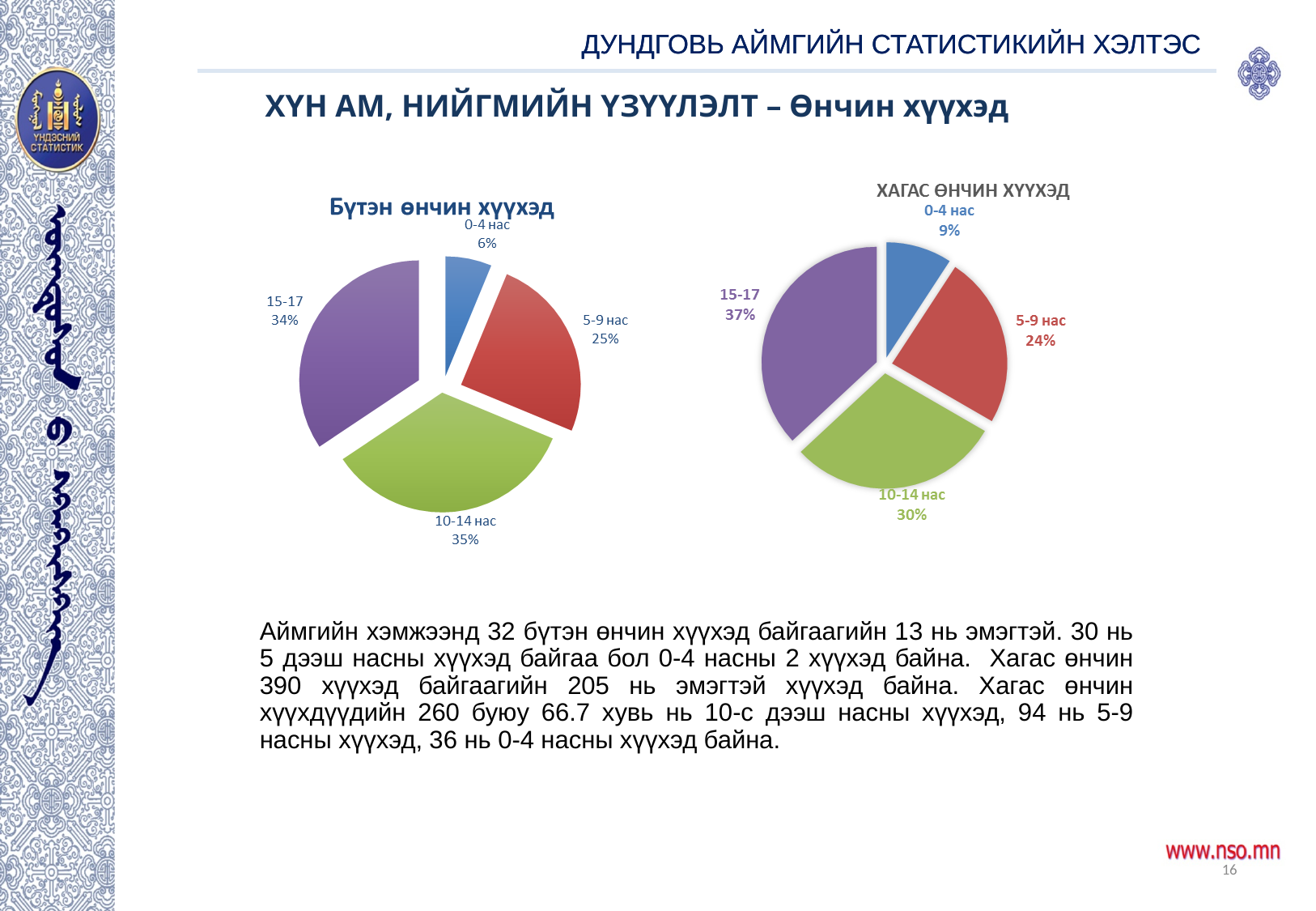
In the "ХАГАС ӨНЧИН ХҮҮХЭД" chart, which age group has the largest slice? 15-17 In the "ХАГАС ӨНЧИН ХҮҮХЭД" chart, what share does the 15-17 slice have? 37% In the "ХАГАС ӨНЧИН ХҮҮХЭД" chart, what is the difference in percentage points between the 10-14 нас and 5-9 нас slices? 6 In the "Бүтэн өнчин хүүхэд" chart, what share does the 10-14 нас slice have? 35% In the "ХАГАС ӨНЧИН ХҮҮХЭД" chart, what share does the 0-4 нас slice have? 9% What type of chart is used for "Бүтэн өнчин хүүхэд"? pie chart In the "Бүтэн өнчин хүүхэд" chart, what is the difference in percentage points between the 15-17 and 0-4 нас slices? 28 Which chart has a larger share for 0-4 нас, "Бүтэн өнчин хүүхэд" or "ХАГАС ӨНЧИН ХҮҮХЭД"? ХАГАС ӨНЧИН ХҮҮХЭД What is the title of the pie chart on the right side of the slide? ХАГАС ӨНЧИН ХҮҮХЭД How many slices does the "Бүтэн өнчин хүүхэд" pie chart have? 4 In the "Бүтэн өнчин хүүхэд" chart, which age group has the smallest slice? 0-4 нас